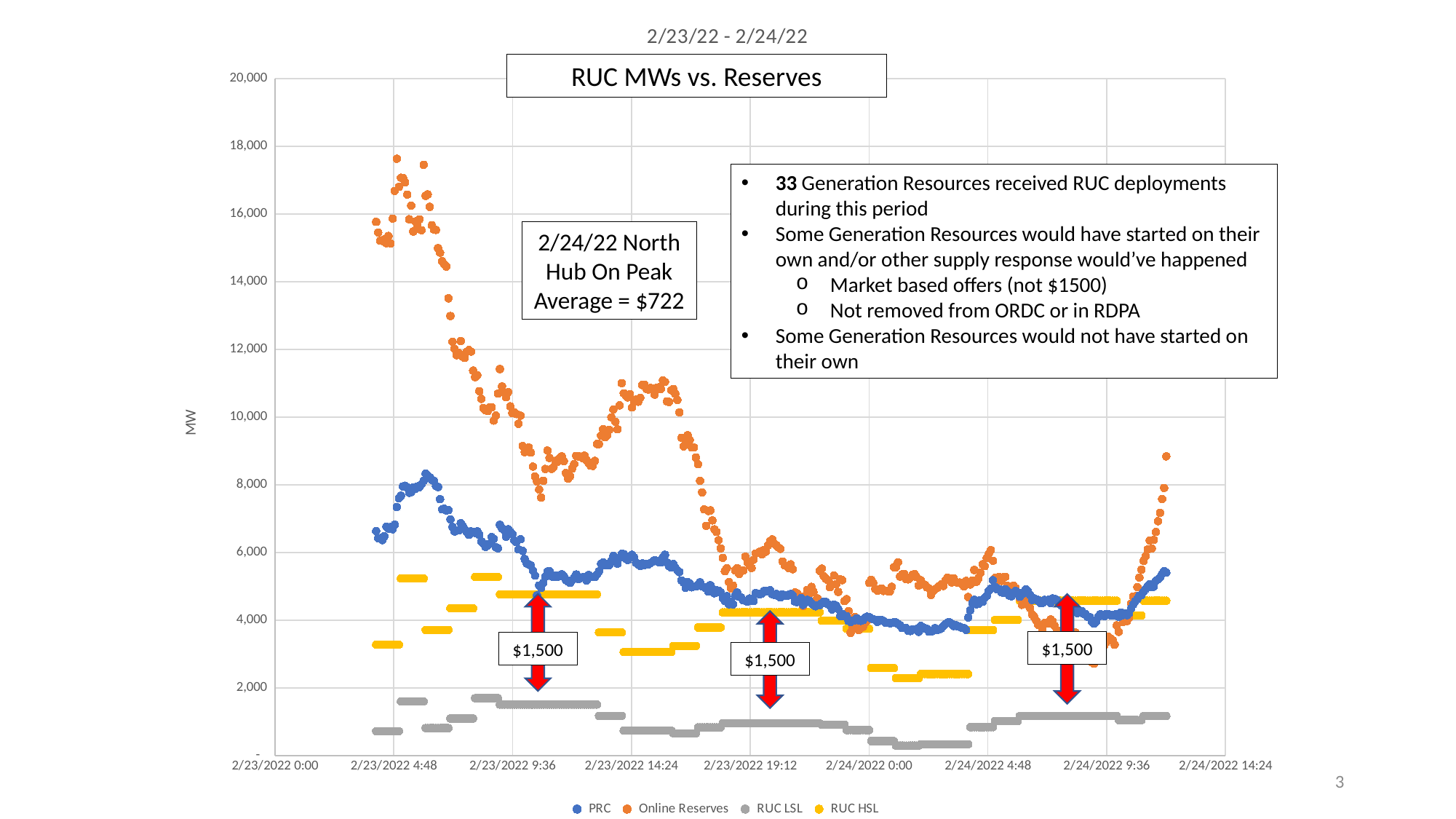
Is the value of Online Reserves at 2/23/2022 14:24 greater or less than 10,000? greater Is the peak value of Online Reserves near 2/23/2022 4:48 greater or less than 16,000? greater Which series reaches the highest value on the chart? Online Reserves What is the title of the chart? 2/23/22 - 2/24/22 At 2/23/2022 4:48, which is larger: Online Reserves or PRC? Online Reserves What is the label on the vertical axis? MW Are the RUC LSL values ever greater than 2,000? No Does the Online Reserves series generally rise or fall between 2/23/2022 4:48 and 2/24/2022 0:00? Fall What type of chart is shown on the slide? Scatter chart Which series has the lowest values on the chart? RUC LSL How many series does the legend list? 4